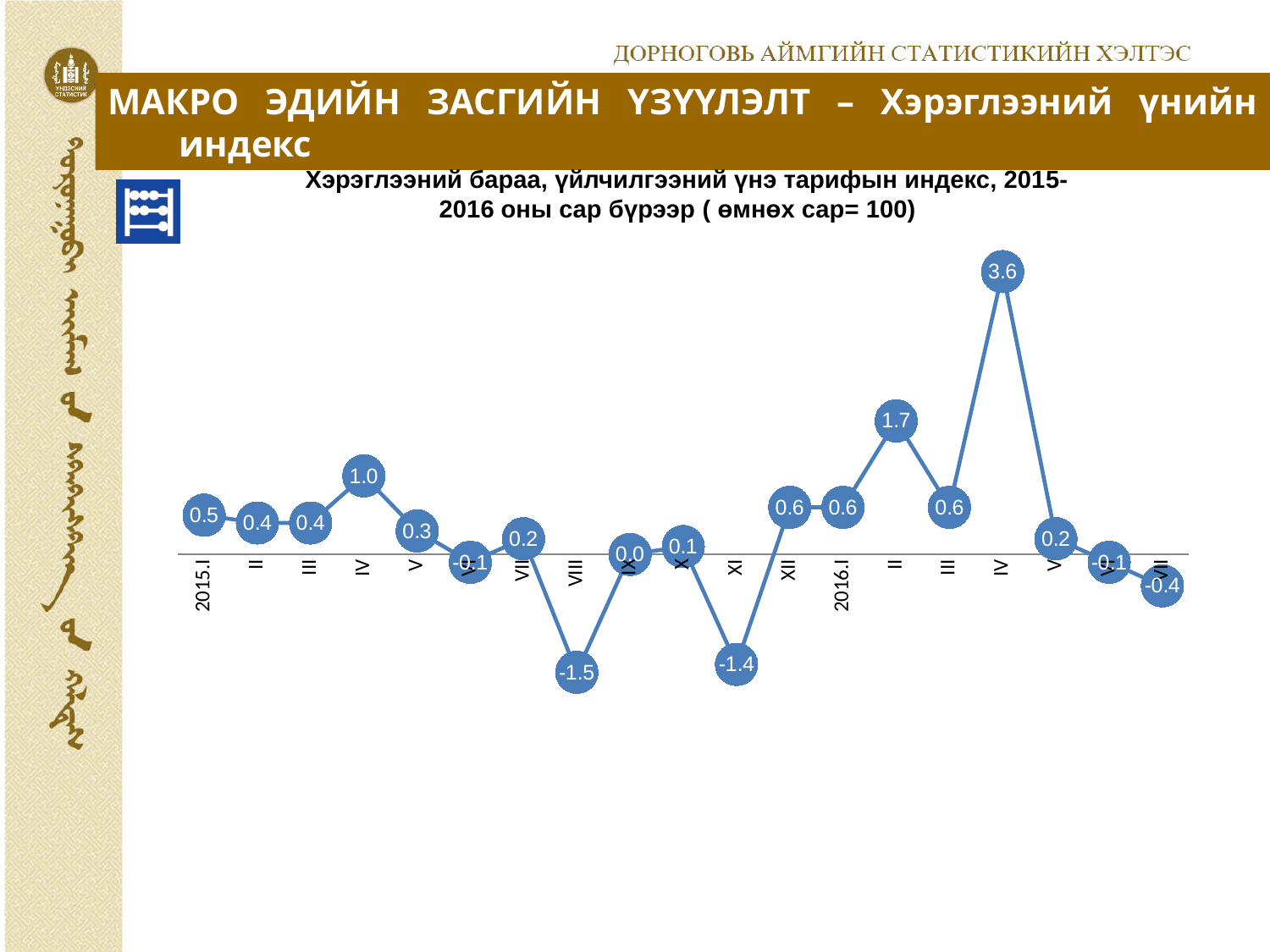
How many data points are plotted on the chart? 19 What is the value for 2015 VIII? -1.5 What is the value for 2015 XI? -1.4 What is the difference between the values for 2016 IV and 2016 II? 1.9 What is the value for 2016 IV? 3.6 Do the values rise or fall from 2016 IV to 2016 VII? Fall Which is larger, the value for 2015 IV or the value for 2016 II? 2016 II Which month has the highest value? 2016 IV What kind of chart is shown on the slide? Line chart What is the value for 2015 IV? 1.0 Which month has the lowest value? 2015 VIII What is the value for 2016 II? 1.7